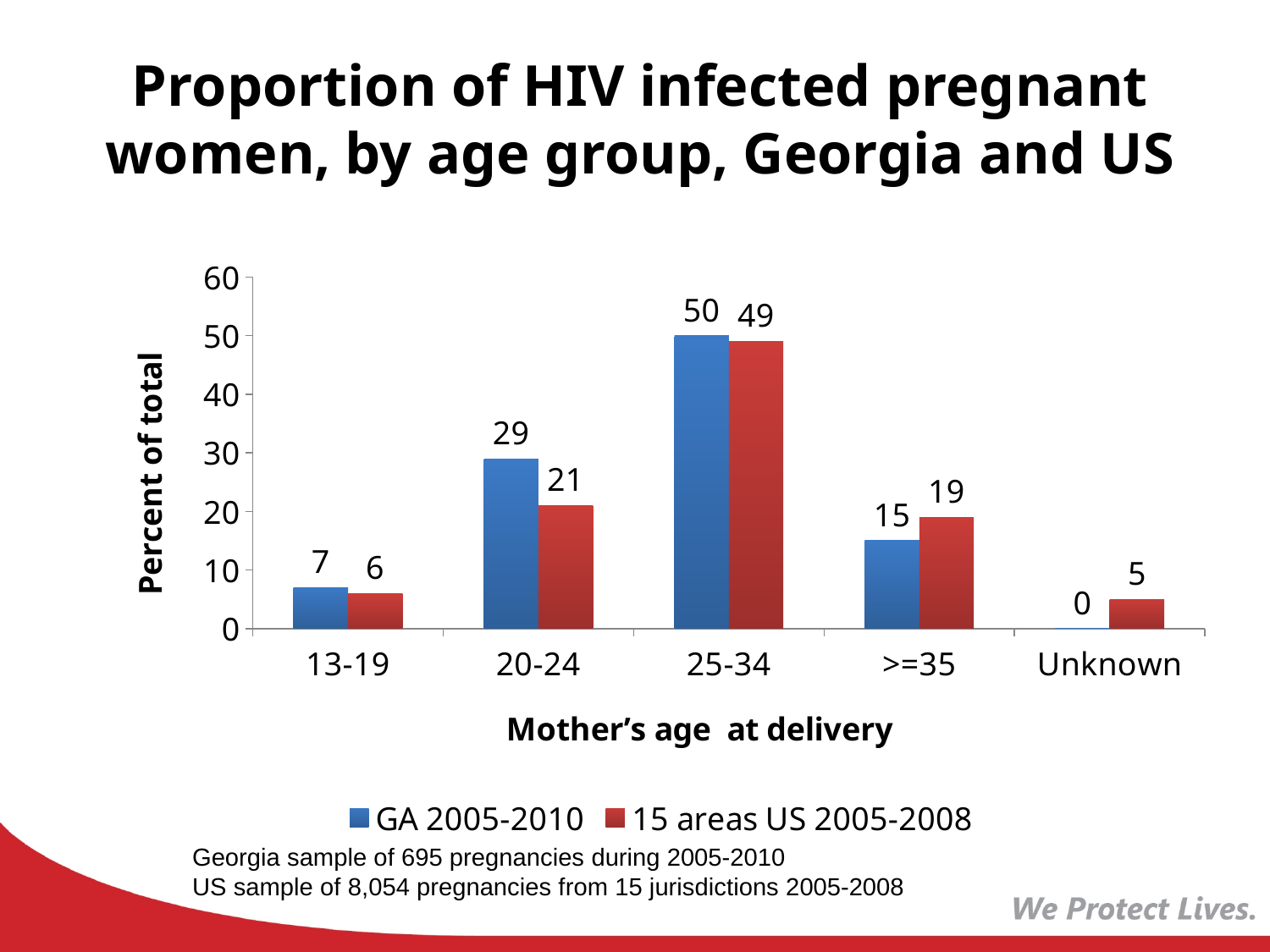
What is the value for 15 areas US 2005-2008 in the >=35 age group? 19 How many series does the legend list? 2 What is the label of the y axis? Percent of total How many age group categories are shown on the x axis? 5 What is the value for GA 2005-2010 in the 13-19 age group? 7 What is the value for GA 2005-2010 in the 20-24 age group? 29 What is the difference between the GA 2005-2010 and 15 areas US 2005-2008 values in the 20-24 age group? 8 In the >=35 age group, which series has the larger value, GA 2005-2010 or 15 areas US 2005-2008? 15 areas US 2005-2008 Which age group has the highest value for GA 2005-2010? 25-34 What is the value for 15 areas US 2005-2008 in the Unknown age group? 5 What kind of chart is shown on the slide? Bar chart Which age group has the lowest value for 15 areas US 2005-2008? Unknown